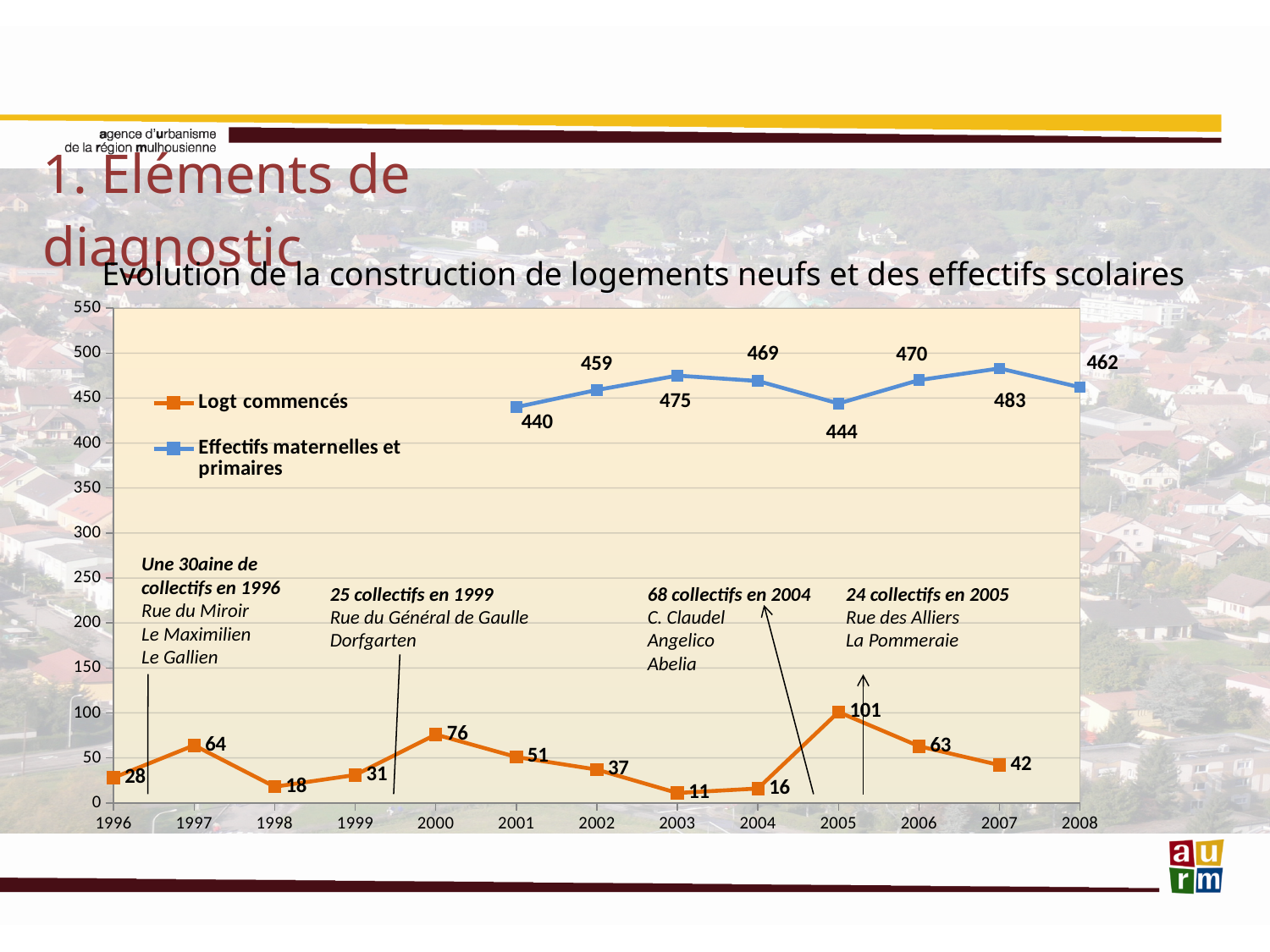
What is the value of 'Logt commencés' in 2000? 76 What is the difference between 'Logt commencés' in 2005 and in 2006? 38 What is the title of the chart? Evolution de la construction de logements neufs et des effectifs scolaires In which year is 'Logt commencés' at its lowest? 2003 Which is larger: 'Logt commencés' in 1997 or in 1998? 1997 What is the difference between 'Effectifs maternelles et primaires' in 2007 and in 2008? 21 What is the value of 'Logt commencés' in 2005? 101 What type of chart is shown on the slide? line chart What is the value of 'Effectifs maternelles et primaires' in 2001? 440 How many years are shown on the x axis? 13 In which year is 'Effectifs maternelles et primaires' at its highest? 2007 How many series does the legend list? 2